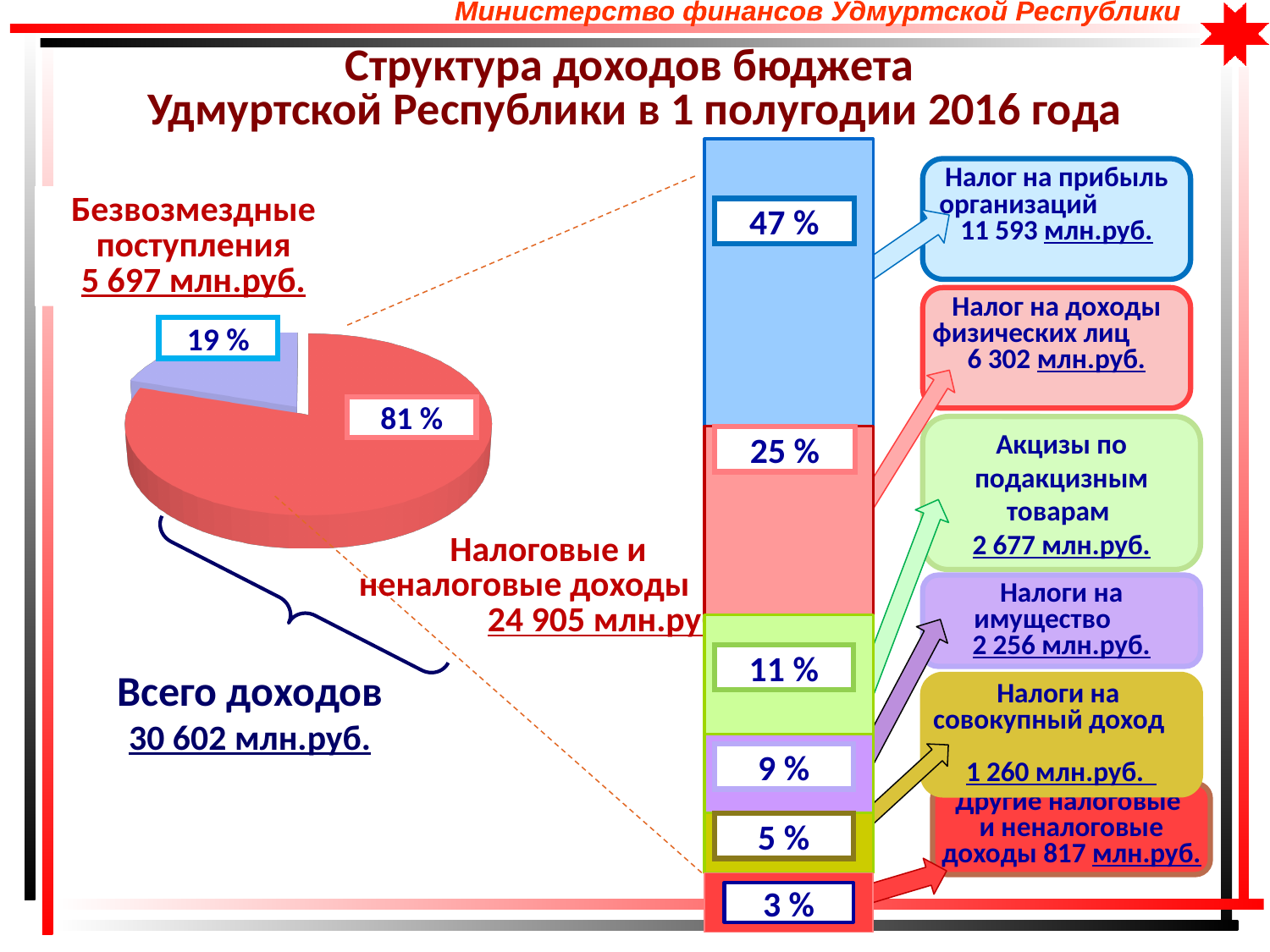
On the pie chart, what share of total revenue is shown for Налоговые и неналоговые доходы? 81 % On the stacked bar, what percentage is shown for Налог на прибыль организаций? 47 % How many segments does the stacked bar on the right contain? 6 On the stacked bar, what is the value in млн.руб. for Налог на доходы физических лиц? 6 302 млн.руб. On the stacked bar, which segment has the smallest percentage? Другие налоговые и неналоговые доходы (3 %) On the stacked bar, which is larger: Акцизы по подакцизным товарам or Налоги на имущество? Акцизы по подакцизным товарам On the stacked bar, which segment has the largest percentage? Налог на прибыль организаций (47 %) On the pie chart, what share of total revenue is shown for Безвозмездные поступления? 19 % What total revenue (Всего доходов) is shown on the slide? 30 602 млн.руб. On the stacked bar, what is the difference in percentage points between Налог на прибыль организаций and Налог на доходы физических лиц? 22 percentage points On the pie chart, what is the value in млн.руб. for Налоговые и неналоговые доходы? 24 905 млн.руб. On the pie chart, what is the value in млн.руб. for Безвозмездные поступления? 5 697 млн.руб.